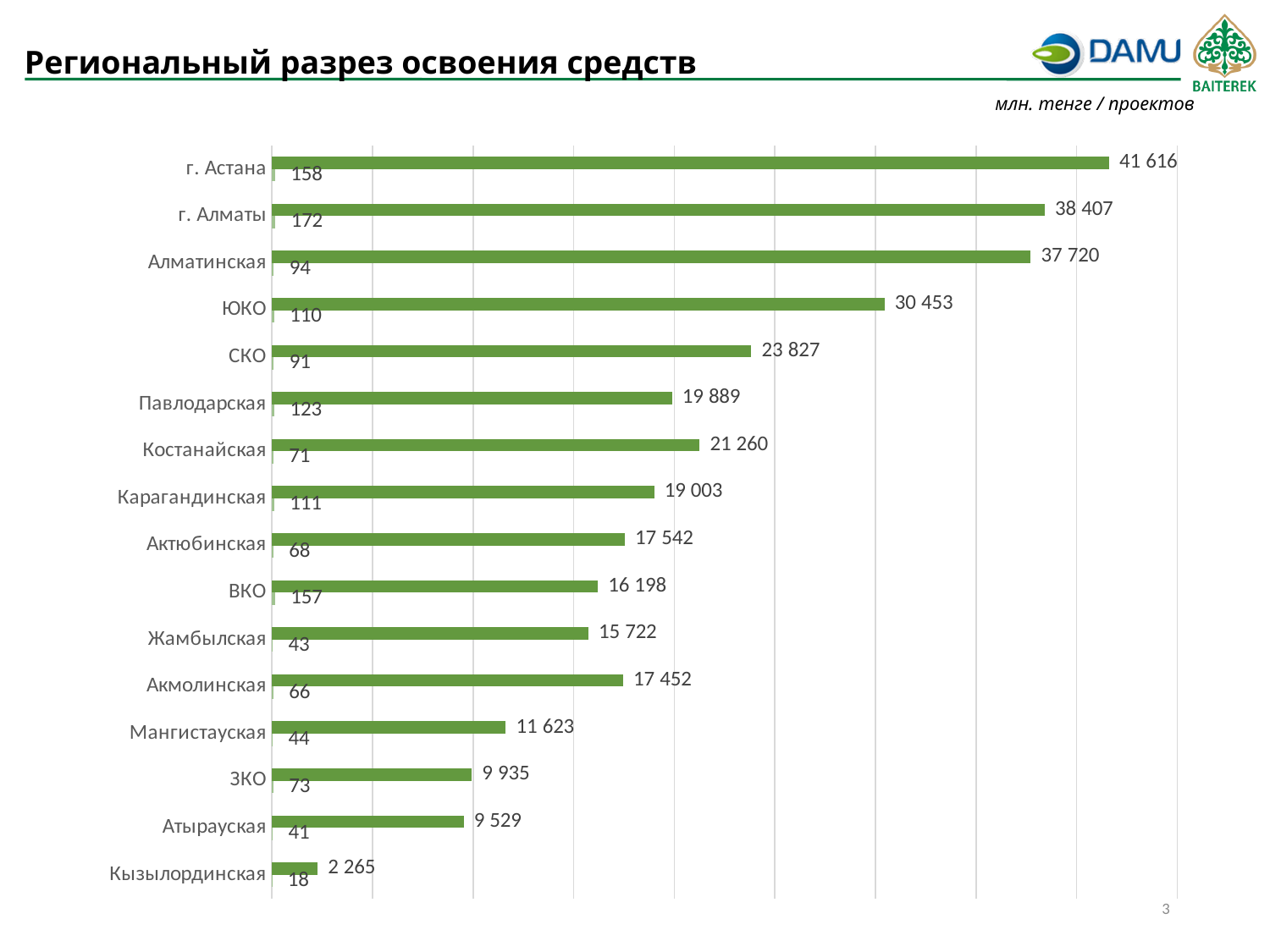
Which region has the lowest amount of funds (млн. тенге)? Кызылординская How many projects are shown for Кызылординская? 18 How many projects are shown for г. Алматы? 172 What is the amount of funds (млн. тенге) shown for Павлодарская? 19 889 Which region has the highest number of projects? г. Алматы Which region has more funds (млн. тенге): Костанайская or Карагандинская? Костанайская What is the difference in funds (млн. тенге) between г. Астана and г. Алматы? 3 209 What type of chart is shown on the slide? Bar chart How many regions are shown on the chart? 16 What is the title of the slide? Региональный разрез освоения средств What is the amount of funds (млн. тенге) shown for г. Астана? 41 616 Which region has the highest amount of funds (млн. тенге)? г. Астана